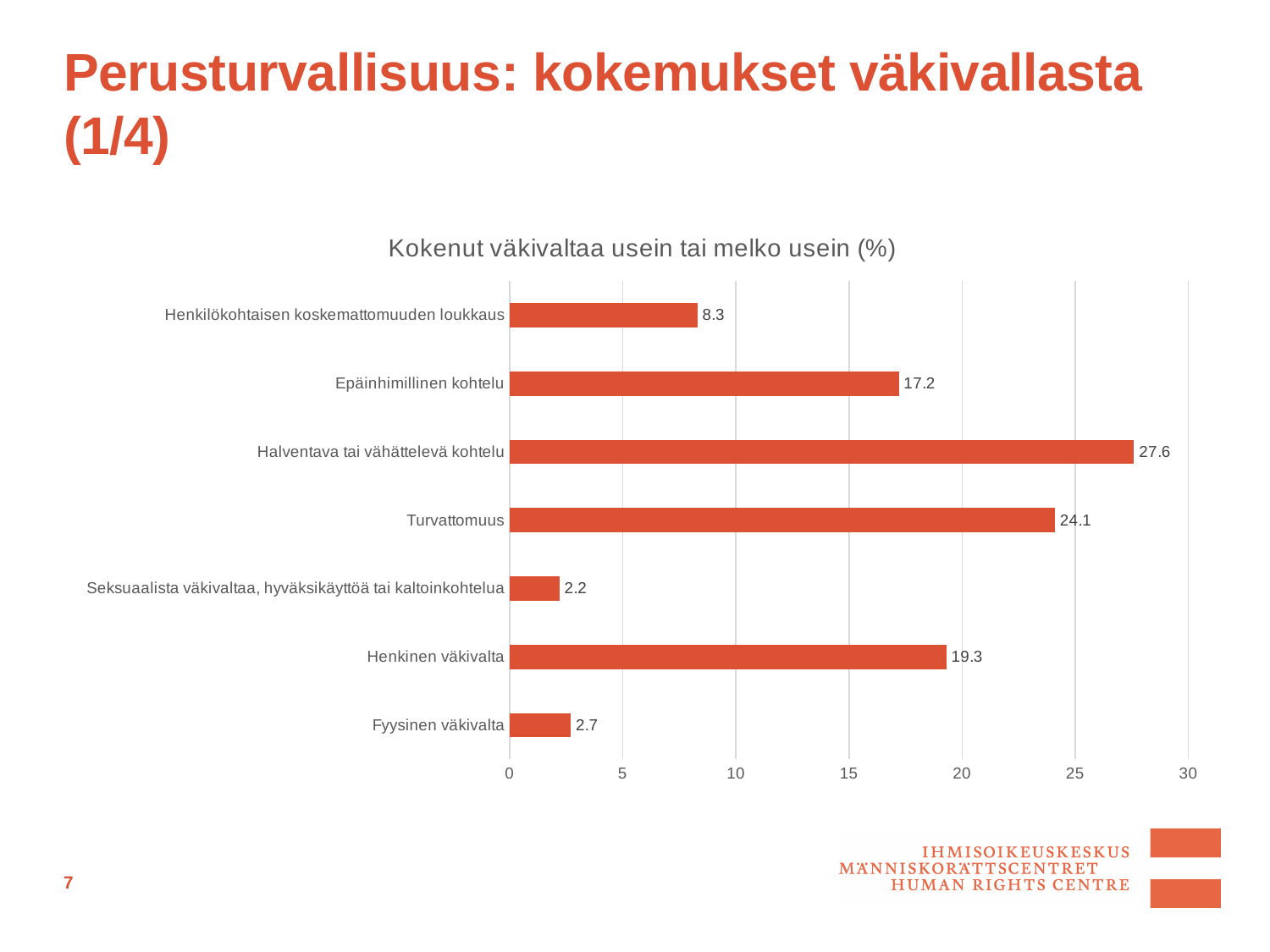
What is the value for Halventava tai vähättelevä kohtelu? 27.6 What is the value for Henkinen väkivalta? 19.3 What is the difference between the values for Fyysinen väkivalta and Seksuaalista väkivaltaa, hyväksikäyttöä tai kaltoinkohtelua? 0.5 How many categories are shown in the chart? 7 Which category has the highest value? Halventava tai vähättelevä kohtelu What is the title of the chart? Kokenut väkivaltaa usein tai melko usein (%) What is the value for Seksuaalista väkivaltaa, hyväksikäyttöä tai kaltoinkohtelua? 2.2 What is the difference between the values for Turvattomuus and Epäinhimillinen kohtelu? 6.9 Which category has the lowest value? Seksuaalista väkivaltaa, hyväksikäyttöä tai kaltoinkohtelua What kind of chart is shown on the slide? bar chart Which is larger, the value for Henkinen väkivalta or the value for Epäinhimillinen kohtelu? Henkinen väkivalta Is the value for Henkilökohtaisen koskemattomuuden loukkaus greater or less than 10? less